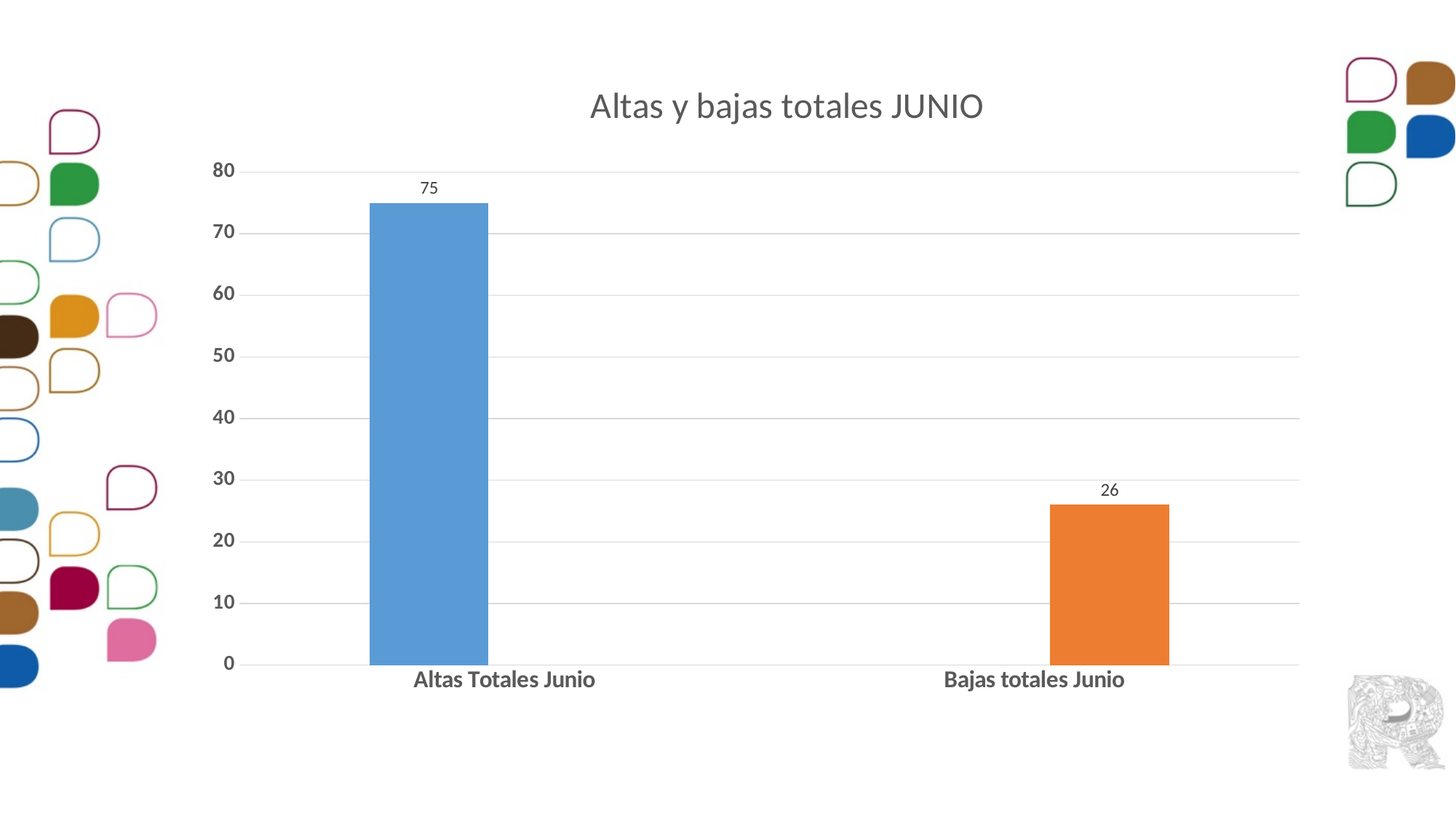
What colour is the bar for Bajas totales Junio? orange What is the value for Bajas totales Junio? 26 Is the value for Altas Totales Junio greater or less than 70? greater What is the value for Altas Totales Junio? 75 What kind of chart is shown on the slide? bar chart How many categories are shown in the chart? 2 Which category has the highest value? Altas Totales Junio What is the title of the chart? Altas y bajas totales JUNIO What is the difference between Altas Totales Junio and Bajas totales Junio? 49 Is the value for Bajas totales Junio greater or less than 30? less Which is larger, Altas Totales Junio or Bajas totales Junio? Altas Totales Junio Which category has the lowest value? Bajas totales Junio